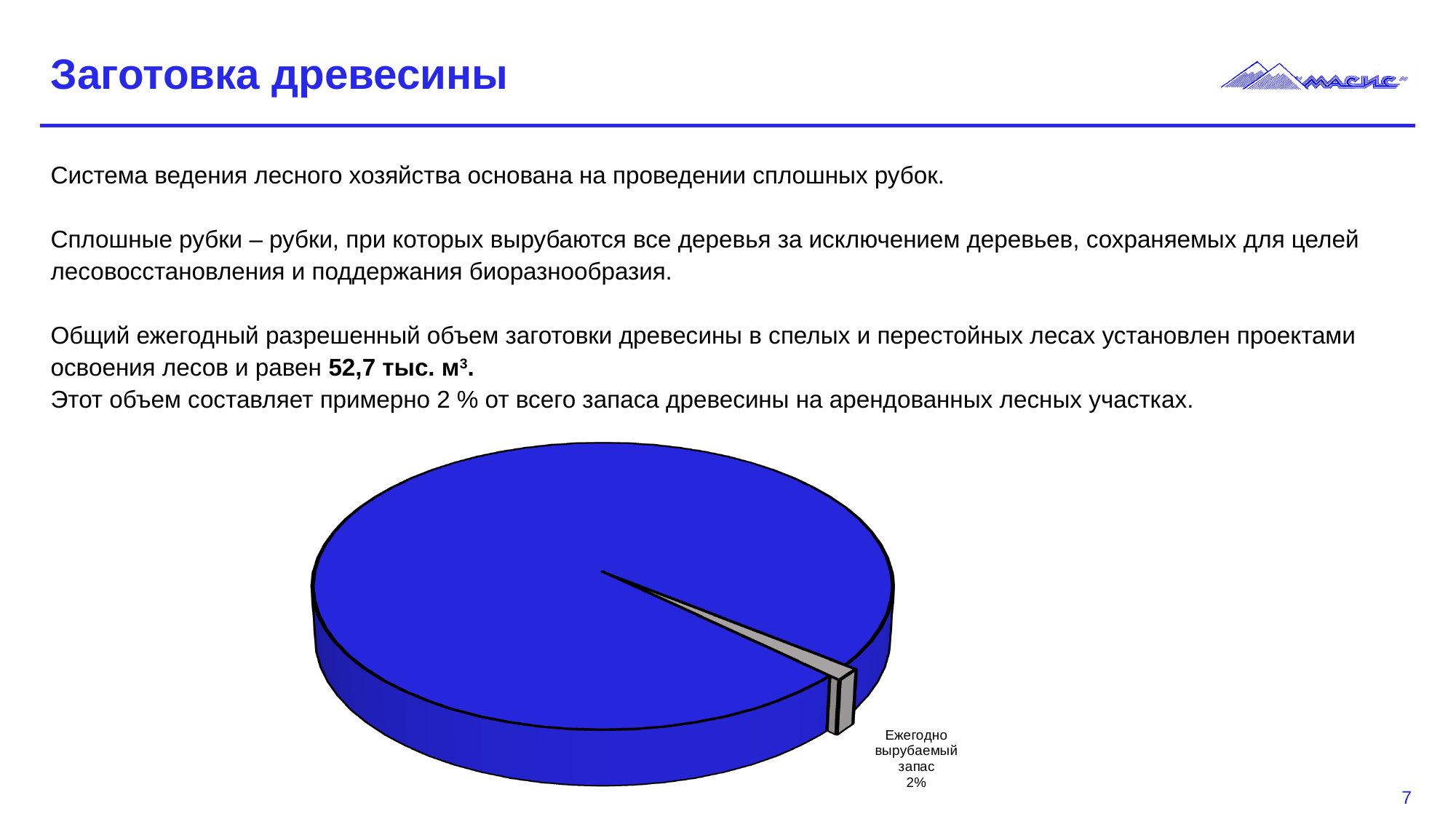
What kind of chart is shown on the slide? Pie chart What colour is the large slice of the pie chart? Blue What is the label of the small separated slice in the pie chart? Ежегодно вырубаемый запас What share of the pie does the slice labeled "Ежегодно вырубаемый запас" represent? 2% Which is larger: the slice labeled "Ежегодно вырубаемый запас" or the unlabeled blue slice? The unlabeled blue slice Is the slice labeled "Ежегодно вырубаемый запас" the largest or the smallest slice of the pie? Smallest Is the share of the slice labeled "Ежегодно вырубаемый запас" greater or less than 10%? less How many slices does the pie chart have? 2